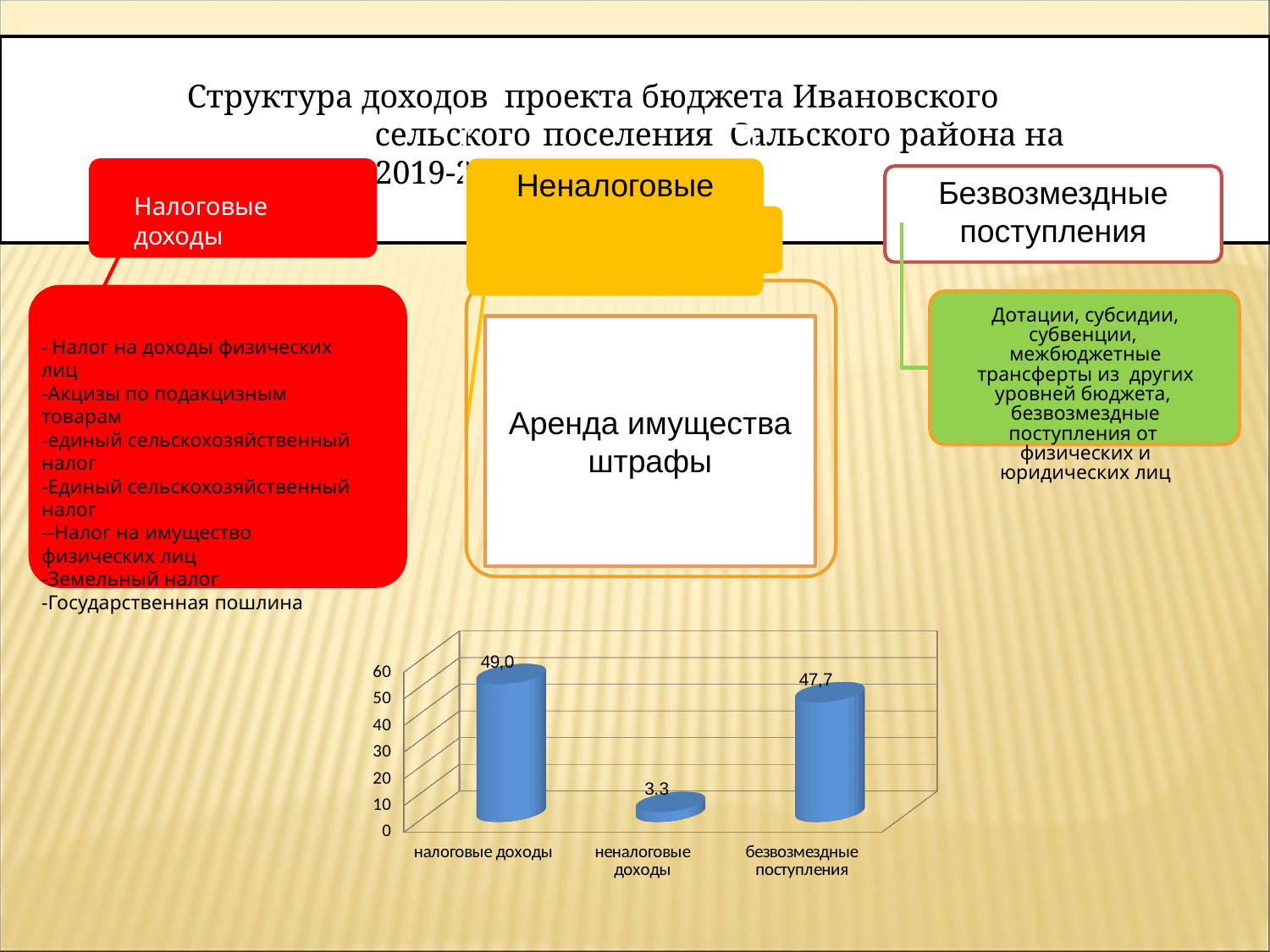
What is the value for налоговые доходы? 49,0 Which category has the lowest value? неналоговые доходы Is the value for безвозмездные поступления greater or less than 40? greater Which is larger, the value for налоговые доходы or the value for неналоговые доходы? налоговые доходы What kind of chart is shown on the slide? bar chart What is the difference between the values for безвозмездные поступления and неналоговые доходы? 44,4 How many categories are shown on the chart? 3 Which category has the highest value? налоговые доходы Is the value for неналоговые доходы greater or less than 10? less What is the value for безвозмездные поступления? 47,7 What is the difference between the values for налоговые доходы and безвозмездные поступления? 1,3 What is the value for неналоговые доходы? 3,3